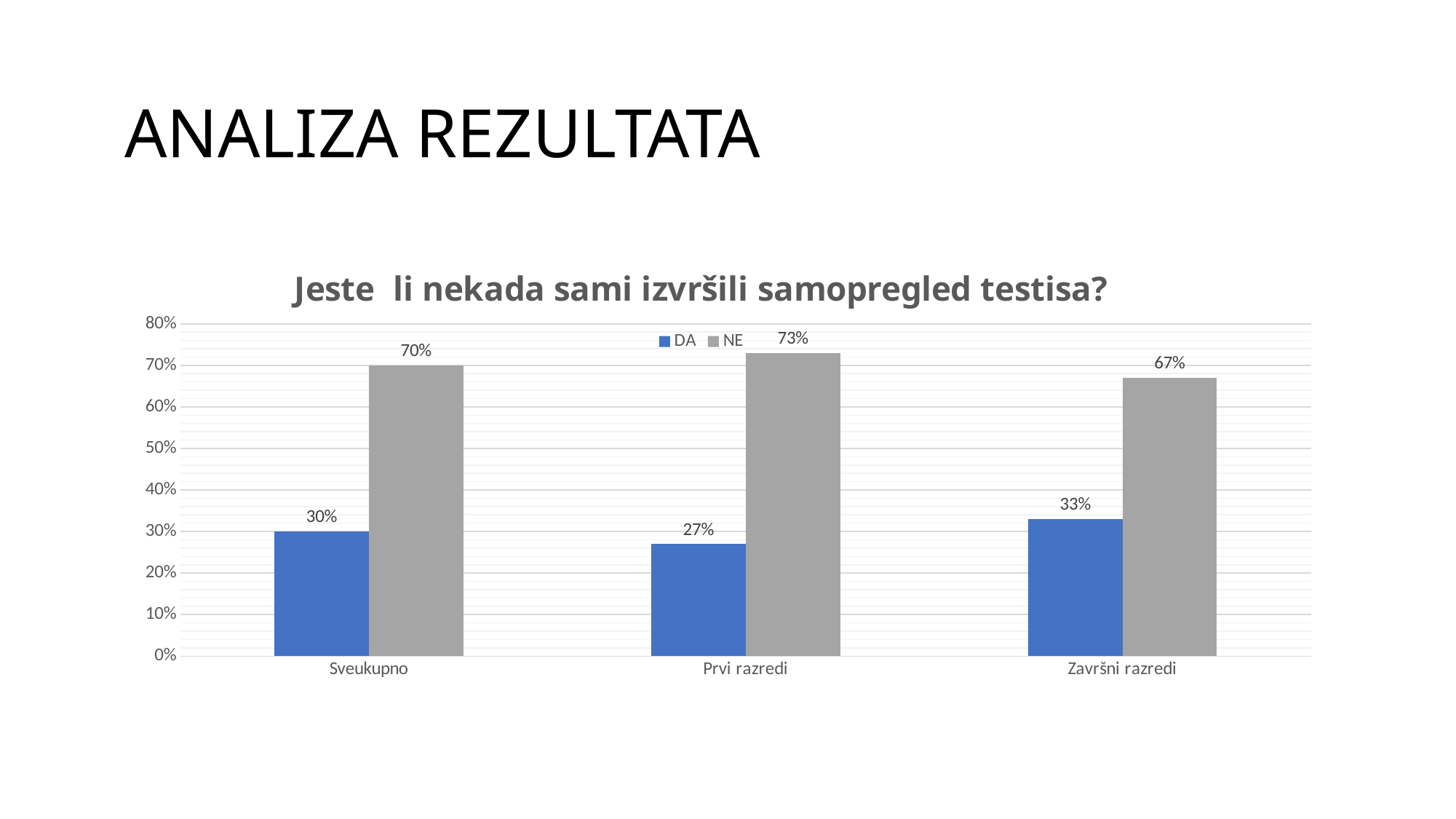
What is the difference between the NE and DA values for Sveukupno? 40% What kind of chart is shown on the slide? Bar chart What is the NE value for Prvi razredi? 73% What is the DA value for Završni razredi? 33% How many categories are shown on the x axis? 3 Which category has the lowest DA value? Prvi razredi What is the title of the chart? Jeste li nekada sami izvršili samopregled testisa? Which category has the highest NE value? Prvi razredi What is the DA value for Sveukupno? 30% Which is larger: the DA value for Završni razredi or the DA value for Prvi razredi? Završni razredi How many series does the legend list? 2 What is the NE value for Završni razredi? 67%